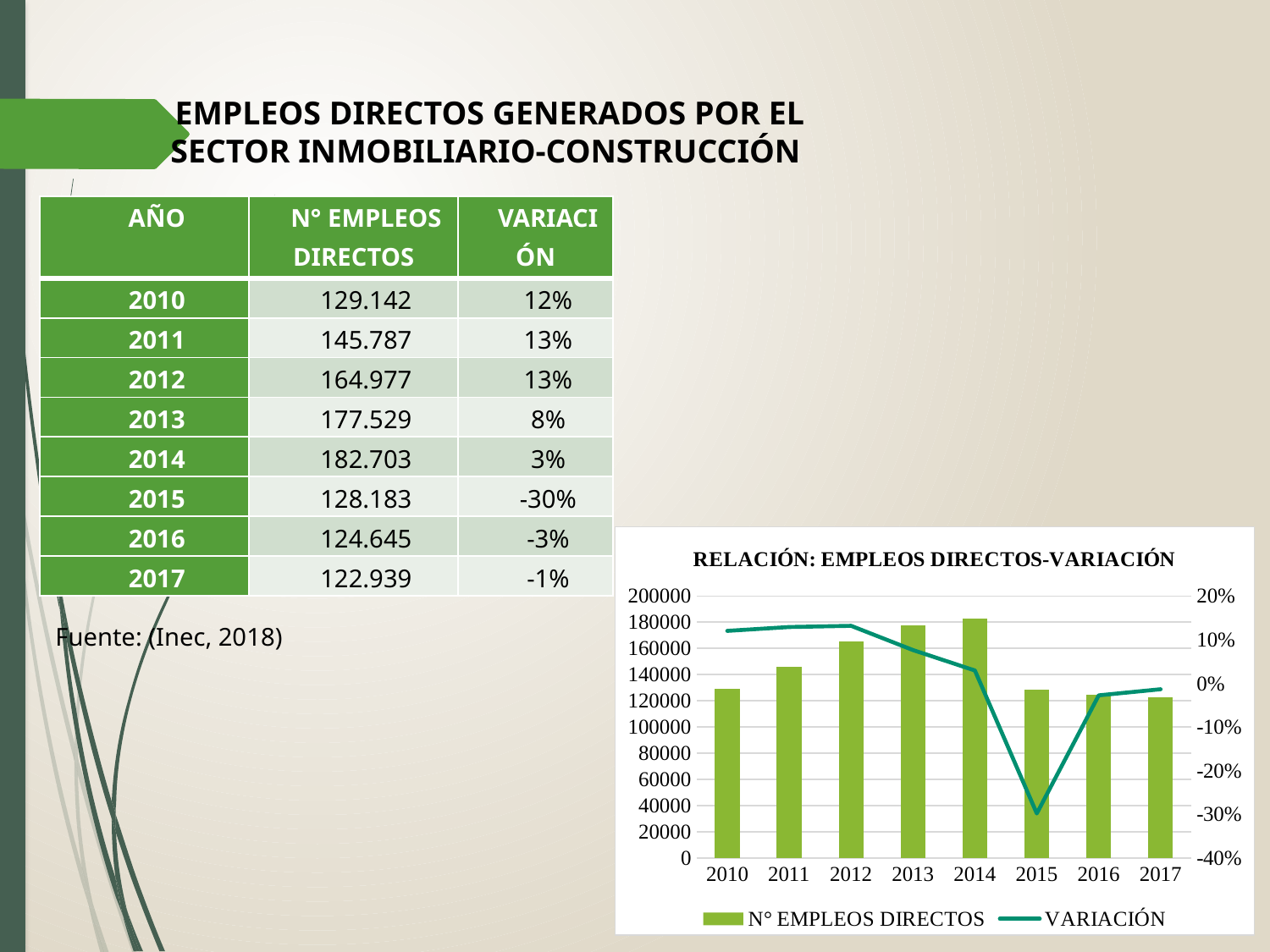
Is the N° EMPLEOS DIRECTOS bar for 2011 greater or less than 140000? greater How many years are plotted on the x axis of the chart? 8 In which year does the VARIACIÓN line reach its lowest point? 2015 What kind of chart is shown on the slide? A combined bar and line chart Do the N° EMPLEOS DIRECTOS bars rise or fall from 2010 to 2014? rise Is the VARIACIÓN value for 2015 greater or less than -20%? less Which is larger, the N° EMPLEOS DIRECTOS bar for 2012 or for 2016? 2012 What is the title of the chart? RELACIÓN: EMPLEOS DIRECTOS-VARIACIÓN Which year has the highest number of direct jobs (N° EMPLEOS DIRECTOS) in the chart? 2014 Which year has the lowest number of direct jobs (N° EMPLEOS DIRECTOS) in the chart? 2017 How many series does the chart legend list? 2 Is the N° EMPLEOS DIRECTOS bar for 2014 greater or less than 180000? greater